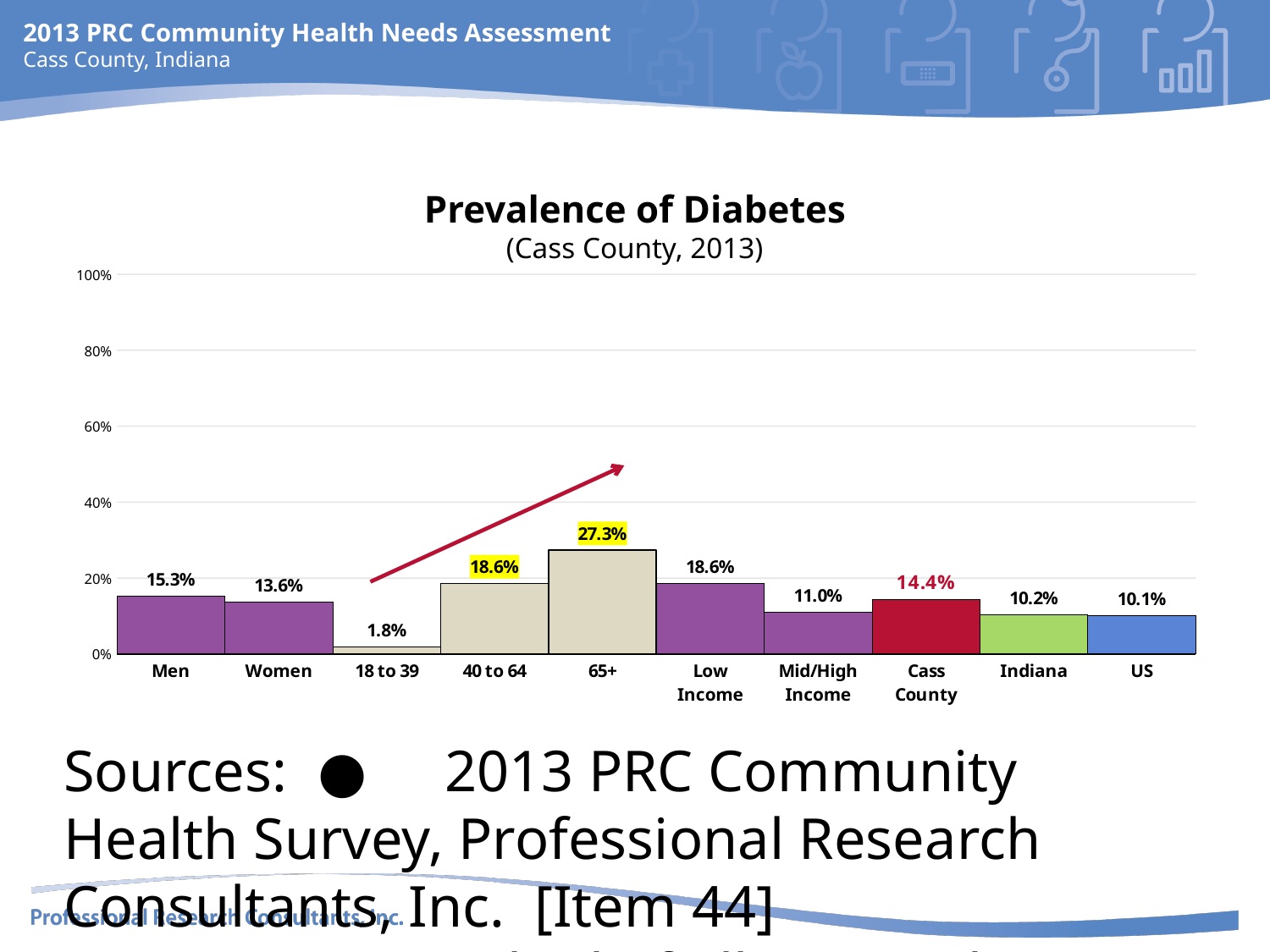
Which category has the highest prevalence of diabetes? 65+ What is the value shown for Cass County? 14.4% What is the prevalence of diabetes for Men? 15.3% Do the values rise or fall across the age groups from 18 to 39 to 65+? rise What is the prevalence of diabetes for the 65+ age group? 27.3% What is the title of the chart? Prevalence of Diabetes What is the difference between the values for Low Income and Mid/High Income? 7.6% What kind of chart is shown on the slide? bar chart How many categories are shown on the x axis? 10 Is the value for 65+ greater or less than 20%? greater Which category has the lowest prevalence of diabetes? 18 to 39 Which is larger, the value for Cass County or the value for Indiana? Cass County